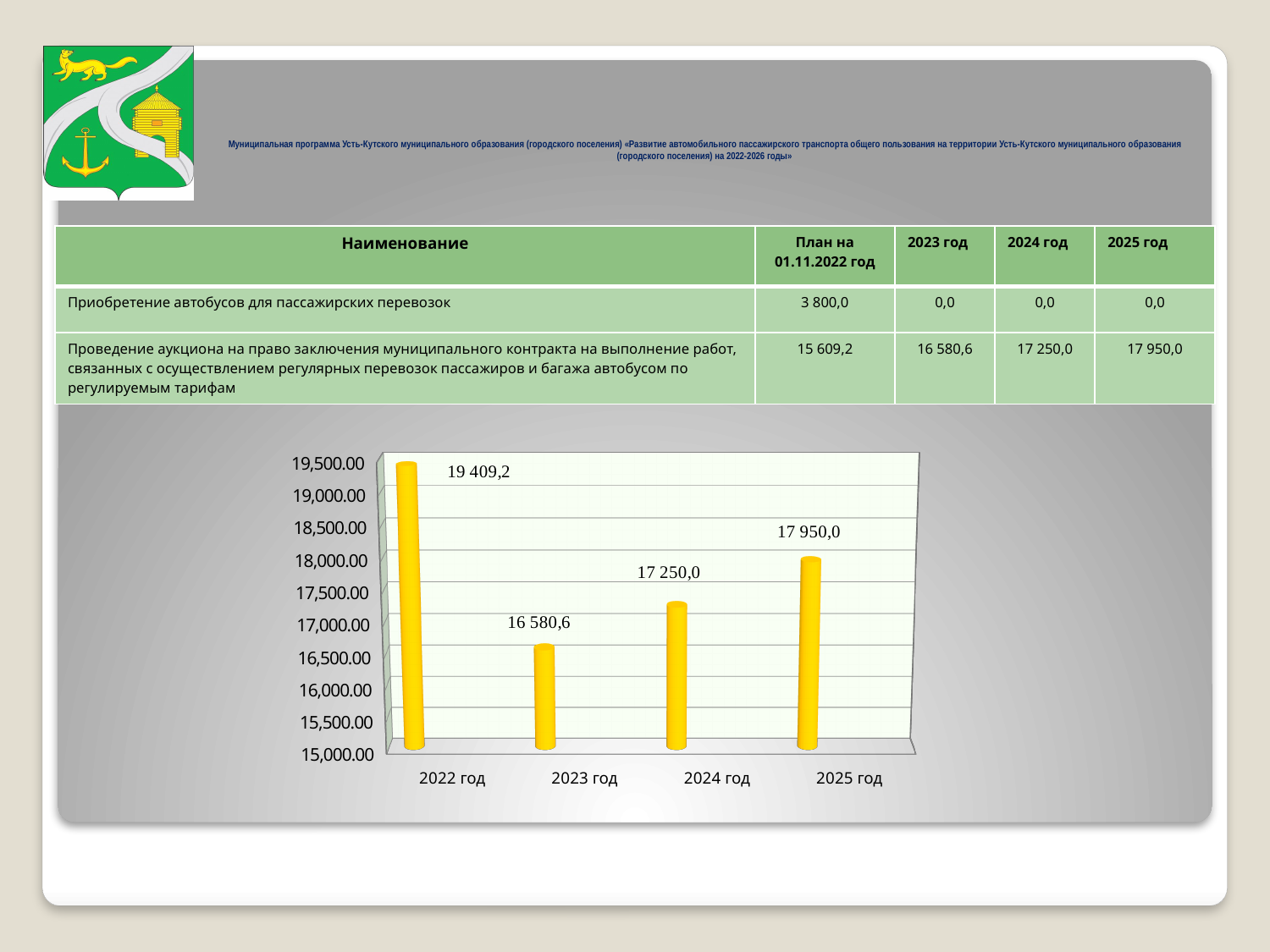
What type of chart is shown on the slide? bar chart What is the value shown for 2024 год in the chart? 17 250,0 Is the value for 2023 год greater or less than 17,000.00? less How many bars are plotted in the chart? 4 What is the value shown for 2023 год in the chart? 16 580,6 Which year has the lowest value in the chart? 2023 год What is the value shown for 2022 год in the chart? 19 409,2 Which year has the highest value in the chart? 2022 год What is the value shown for 2025 год in the chart? 17 950,0 Which is larger in the chart, the value for 2024 год or the value for 2025 год? 2025 год What is the difference between the values for 2025 год and 2024 год in the chart? 700,0 What is the difference between the values for 2022 год and 2023 год in the chart? 2 828,6